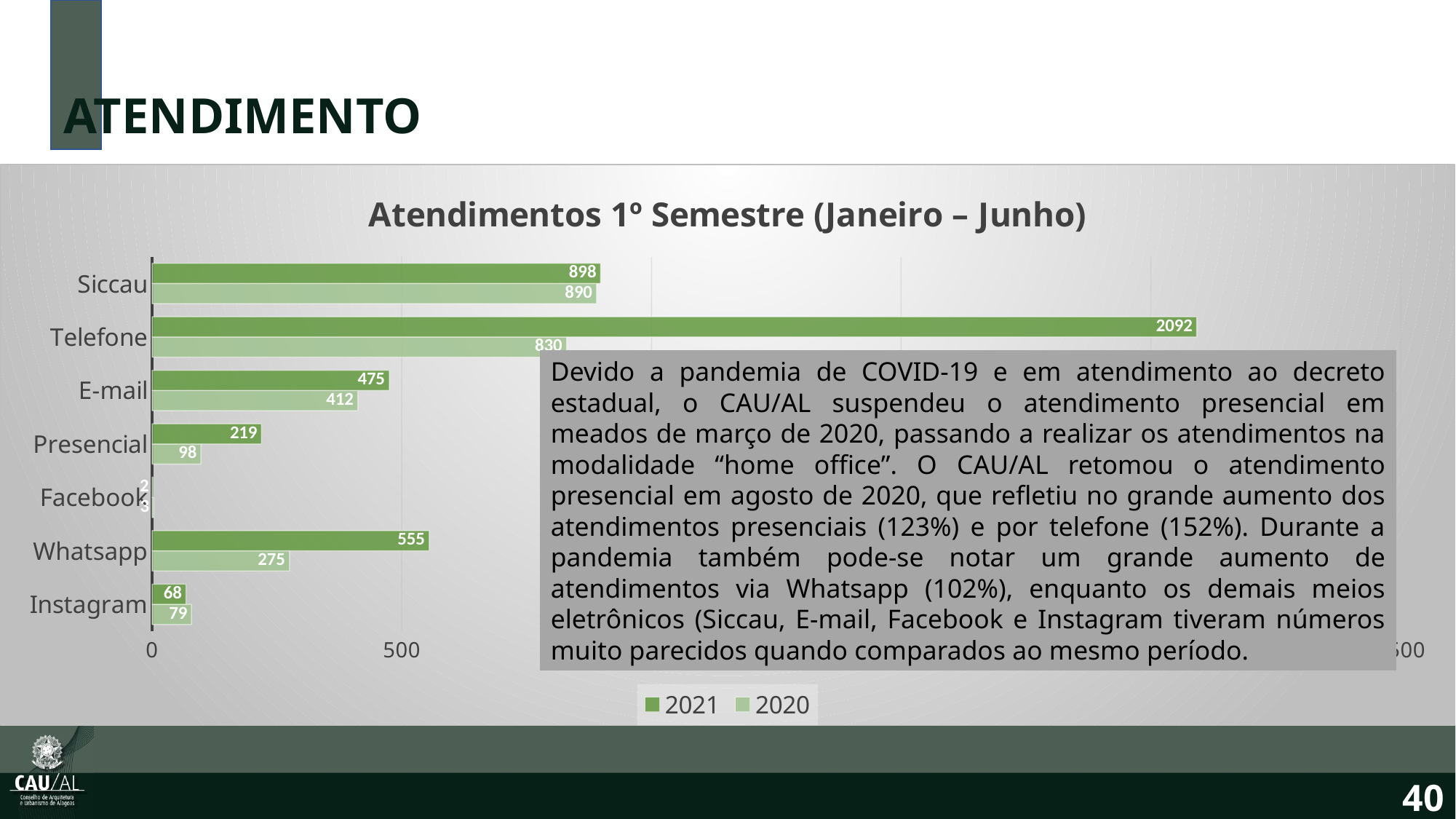
Which is larger for Instagram, the 2021 value or the 2020 value? 2020 What is the difference between the 2021 and 2020 values for Whatsapp? 280 What is the 2021 value for Whatsapp? 555 What is the 2020 value for Siccau? 890 What is the 2020 value for Presencial? 98 What is the 2021 value for Telefone? 2092 How many categories are shown on the chart? 7 How many series does the legend list? 2 Which category has the highest 2021 value? Telefone What kind of chart is shown on the slide? Bar chart What is the difference between the 2021 and 2020 values for E-mail? 63 Is the 2020 value for Telefone greater or less than 500? greater